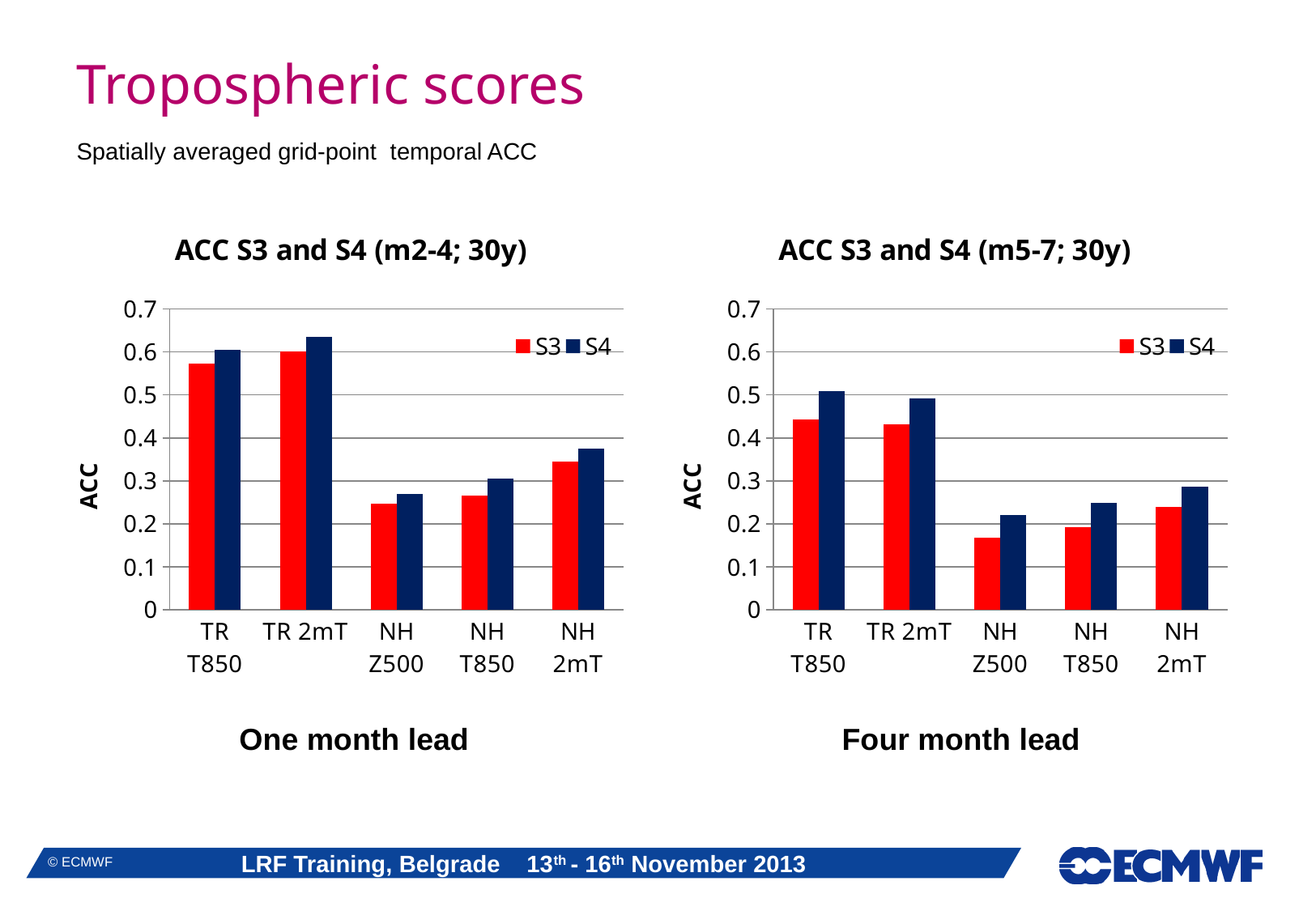
In the right chart 'ACC S3 and S4 (m5-7; 30y)', is the S3 value for NH Z500 greater or less than 0.2? less What kind of chart is the left chart titled 'ACC S3 and S4 (m2-4; 30y)'? bar chart In the right chart 'ACC S3 and S4 (m5-7; 30y)', how many categories are shown on the x axis? 5 In the left chart 'ACC S3 and S4 (m2-4; 30y)', what colour represents the S3 series? red In the left chart 'ACC S3 and S4 (m2-4; 30y)', is the S3 value for TR T850 greater or less than 0.5? greater In the left chart 'ACC S3 and S4 (m2-4; 30y)', which category has the highest S4 value? TR 2mT In the left chart 'ACC S3 and S4 (m2-4; 30y)', which category has the lowest S4 value? NH Z500 In the right chart 'ACC S3 and S4 (m5-7; 30y)', which is larger for TR T850, S3 or S4? S4 In the right chart 'ACC S3 and S4 (m5-7; 30y)', which S4 value is larger, NH T850 or NH 2mT? NH 2mT What is the y-axis title of the right chart 'ACC S3 and S4 (m5-7; 30y)'? ACC In the left chart 'ACC S3 and S4 (m2-4; 30y)', is the S4 value for TR 2mT greater or less than 0.6? greater In the left chart 'ACC S3 and S4 (m2-4; 30y)', how many series does the legend list? 2